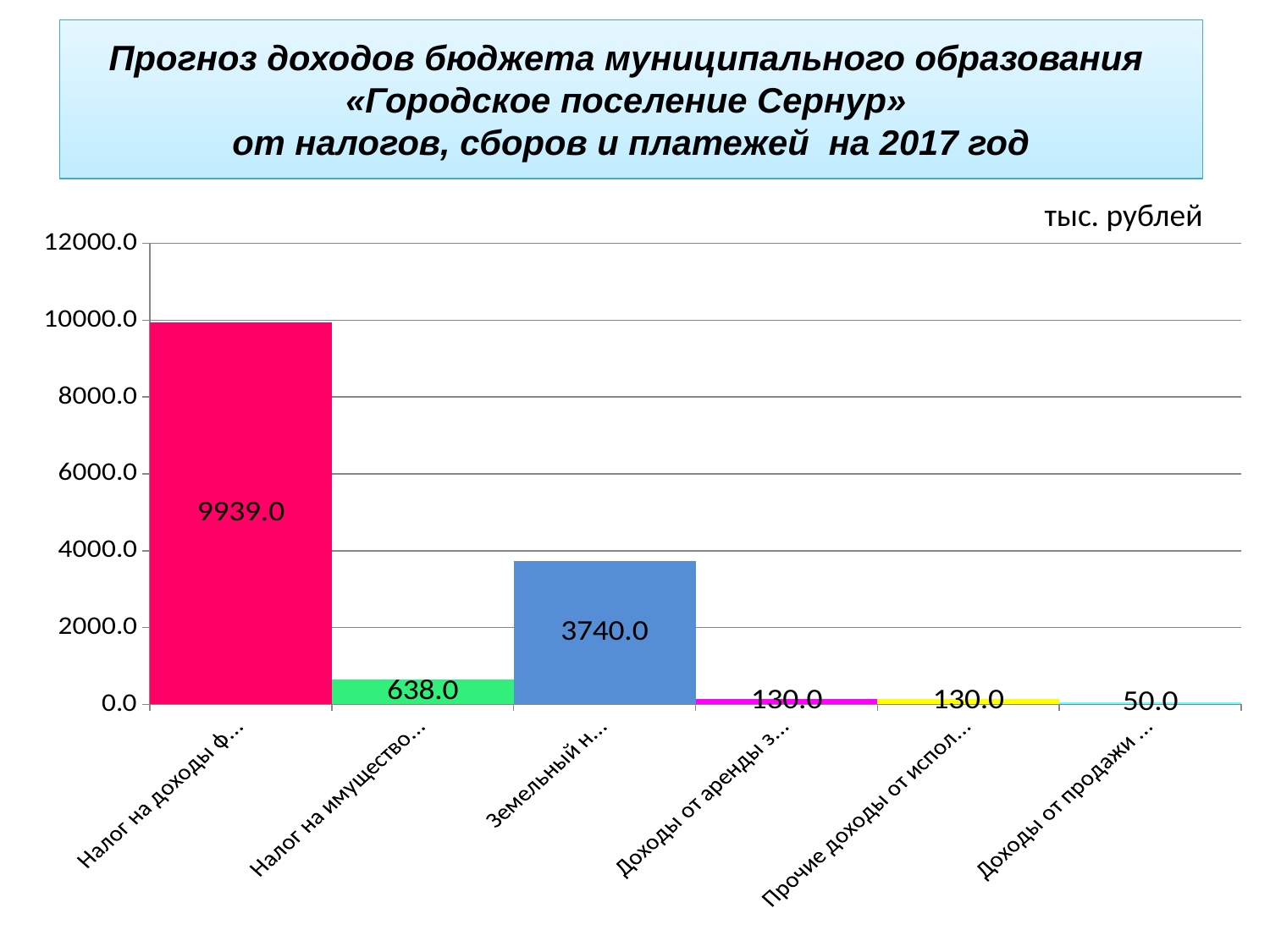
What is the difference between the values for "Налог на доходы ф..." and "Земельный н..."? 6199.0 What type of chart is shown on the slide? bar chart What is the value of the bar for the category beginning "Налог на имущество..."? 638.0 Which is larger: the value for "Налог на имущество..." or the value for "Земельный н..."? Земельный н... Is the value for "Налог на доходы ф..." greater or less than 8000.0? greater What is the value of the bar for the category beginning "Налог на доходы ф..."? 9939.0 What is the value of the bar for the category beginning "Земельный н..."? 3740.0 What is the value of the bar for the category beginning "Доходы от продажи..."? 50.0 Which category has the highest value in the chart? Налог на доходы ф... Which category has the lowest value in the chart? Доходы от продажи ... How many categories (bars) are plotted in the chart? 6 What unit of measurement is indicated above the chart? тыс. рублей